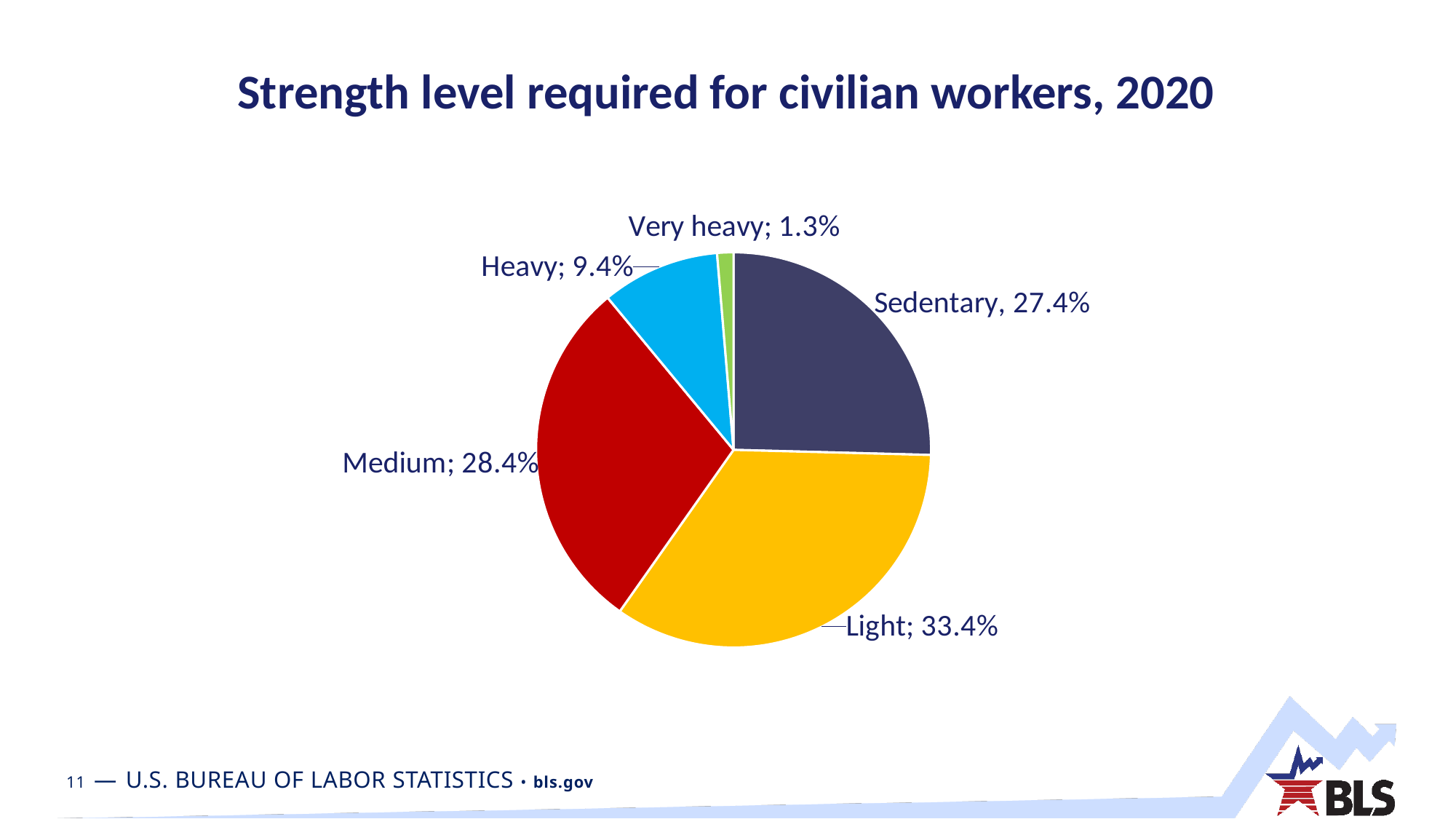
What share of civilian workers require a Heavy strength level? 9.4% What is the difference in percentage points between the Light and Sedentary shares? 6.0 percentage points How many strength level categories are shown in the pie chart? 5 What share of civilian workers require a Very heavy strength level? 1.3% Which strength level has the smallest share of civilian workers? Very heavy What is the title of the chart? Strength level required for civilian workers, 2020 What share of civilian workers require a Sedentary strength level? 27.4% Which strength level has the largest share of civilian workers? Light What share of civilian workers require a Light strength level? 33.4% What type of chart is shown on the slide? Pie chart What is the difference in percentage points between the Heavy and Very heavy shares? 8.1 percentage points Which has a larger share, Medium or Sedentary? Medium